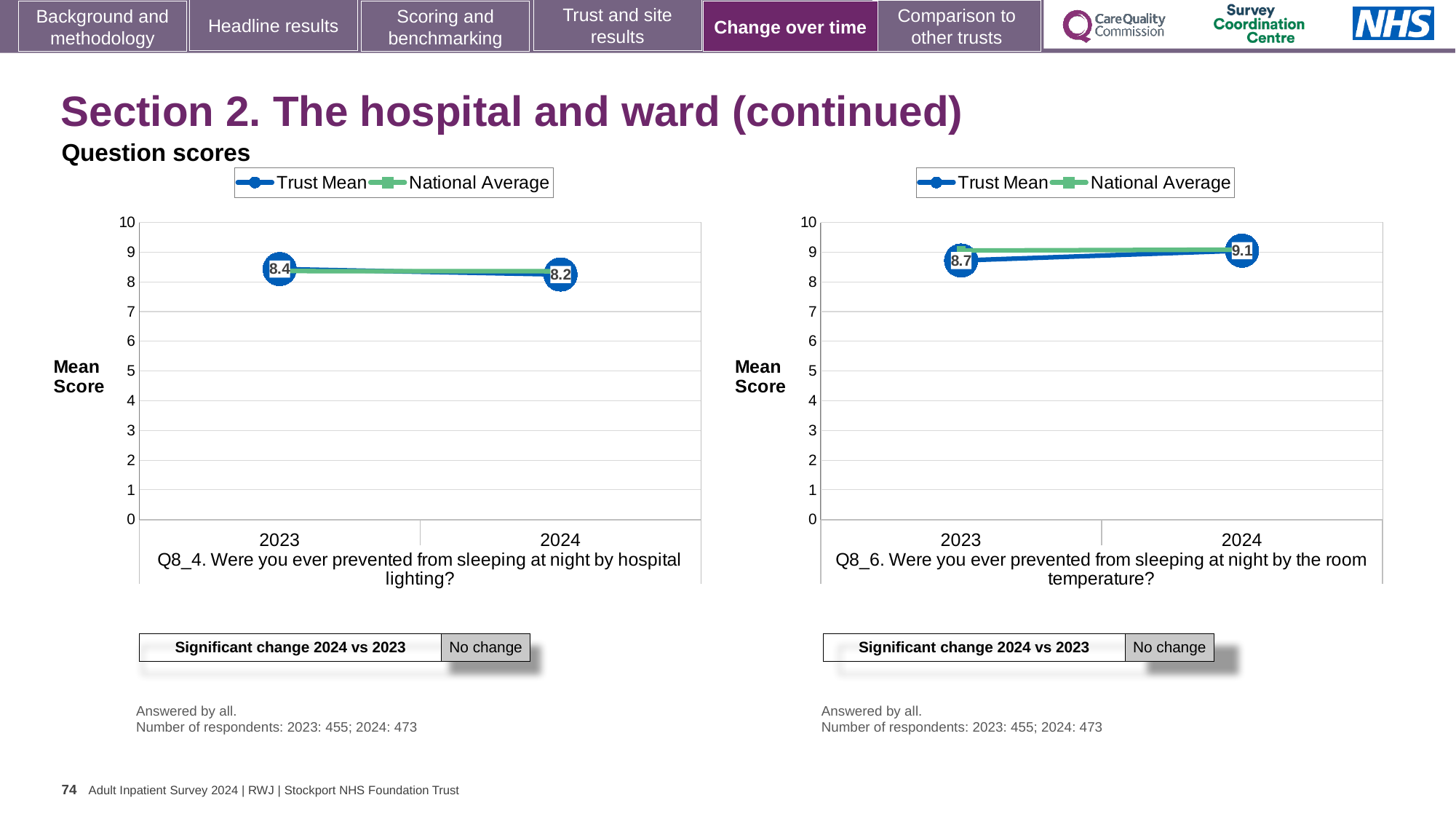
In the left chart (Q8_4), does the Trust Mean rise or fall from 2023 to 2024? fall In the left chart (Q8_4), what is the Trust Mean for 2024? 8.2 In the right chart (Q8_6), which year has the higher Trust Mean, 2023 or 2024? 2024 In the left chart (Q8_4), what is the Trust Mean for 2023? 8.4 In the right chart (Q8_6), does the Trust Mean rise or fall from 2023 to 2024? rise In the right chart (Q8_6), what is the Trust Mean for 2024? 9.1 What kind of chart is the left chart (Q8_4)? line chart In the right chart (Q8_6), what is the Trust Mean for 2023? 8.7 In the left chart (Q8_4), by how much did the Trust Mean change from 2023 to 2024? 0.2 In the left chart (Q8_4), is the National Average for 2023 greater or less than 8? greater How many series does the legend of the right chart (Q8_6) list? 2 In the right chart (Q8_6), what is the difference between the Trust Mean for 2024 and 2023? 0.4